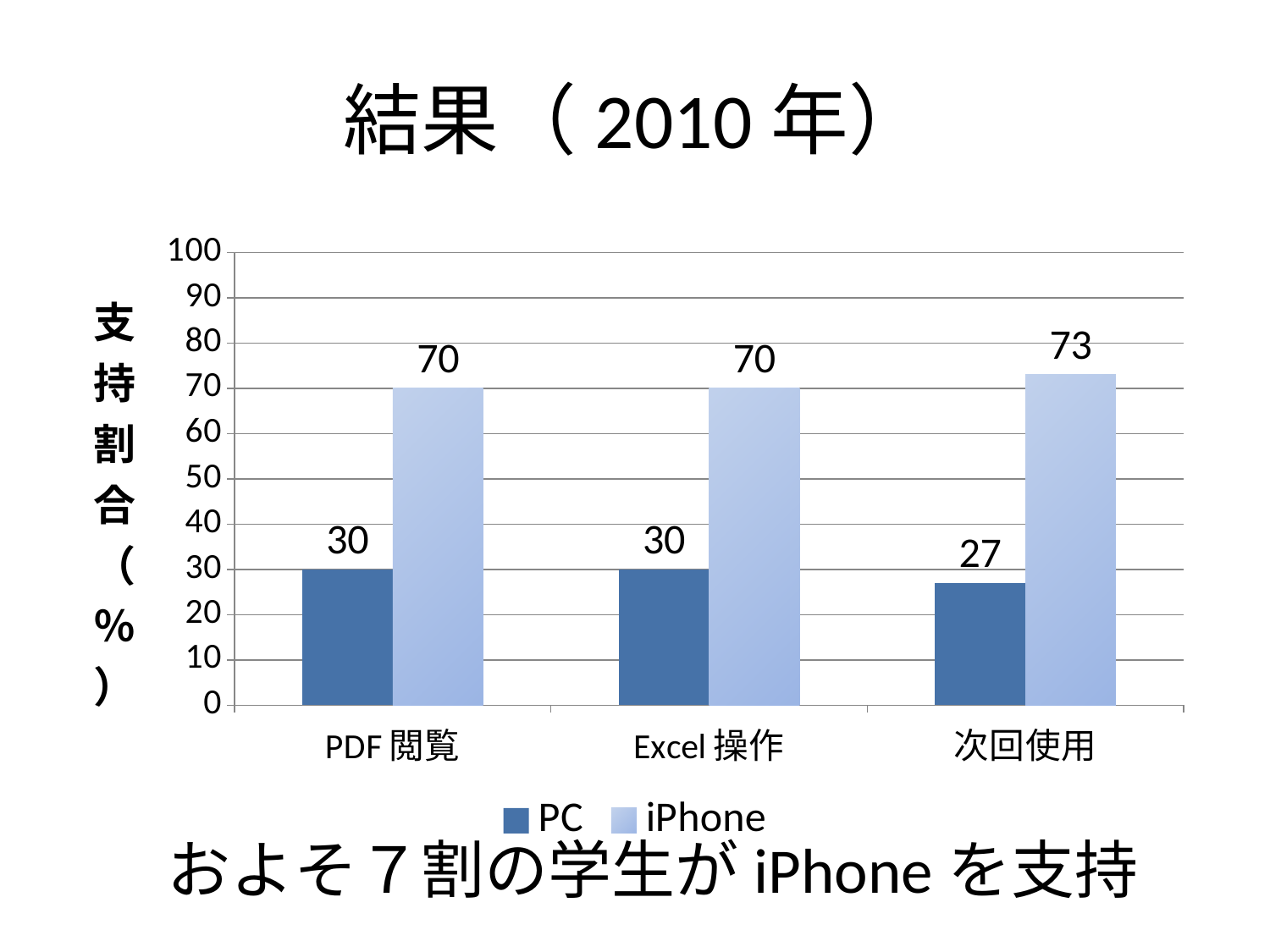
What is the value for PC in the PDF閲覧 category? 30 What is the value for PC in the 次回使用 category? 27 What is the difference between the iPhone and PC values in the 次回使用 category? 46 How many categories are shown on the x axis? 3 In the Excel操作 category, which is larger, PC or iPhone? iPhone Which category has the lowest PC value? 次回使用 What kind of chart is shown on the slide? bar chart What is the difference between the iPhone and PC values in the PDF閲覧 category? 40 What is the value for iPhone in the Excel操作 category? 70 How many series does the legend list? 2 Which category has the highest iPhone value? 次回使用 What is the value for iPhone in the 次回使用 category? 73